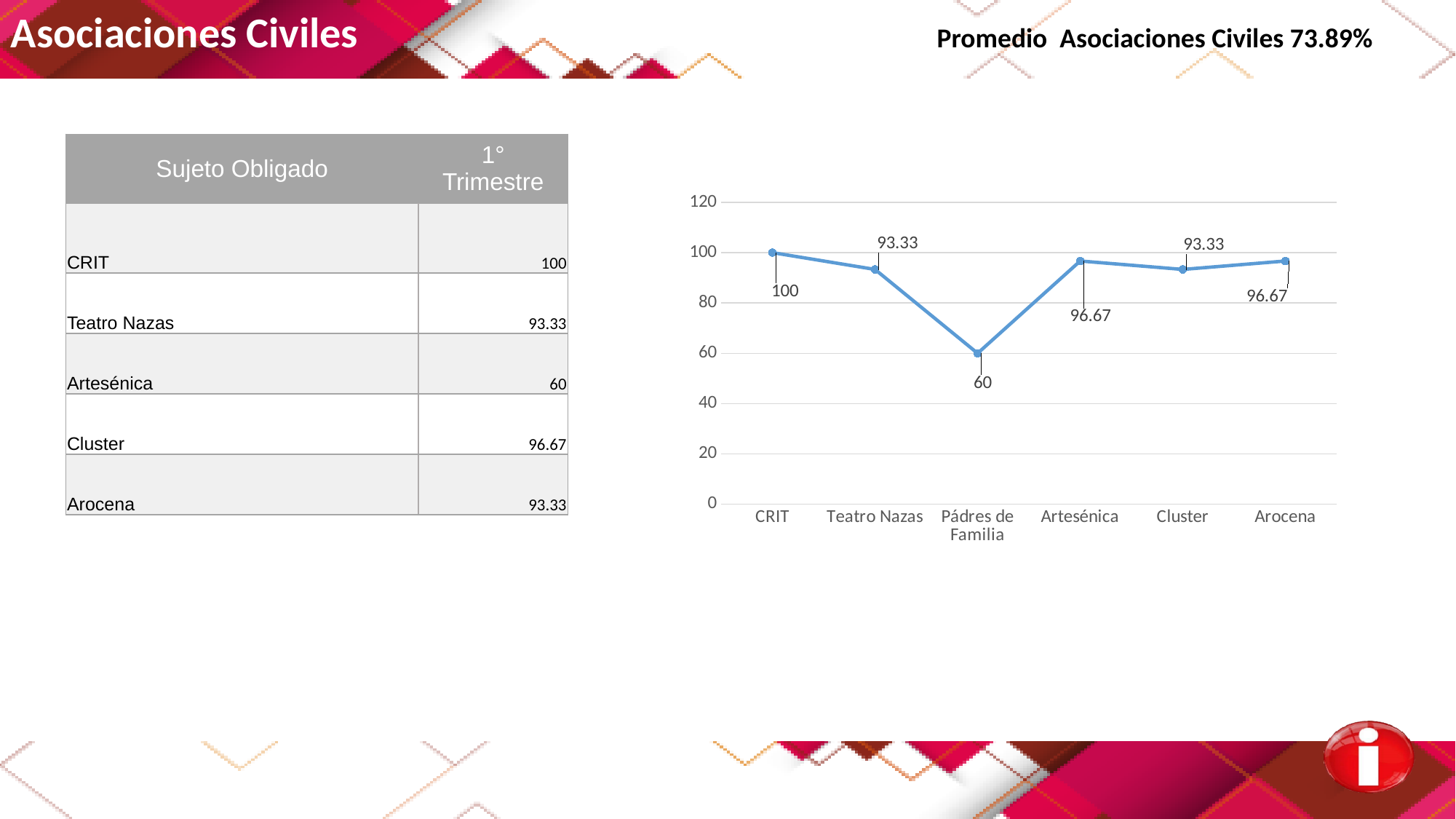
Which category has the lowest value in the chart? Pádres de Familia Which is larger in the chart, the value for Teatro Nazas or the value for Arocena? Arocena What is the value plotted for Cluster in the chart? 93.33 What kind of chart is shown on the slide? line chart How many categories are plotted along the x axis of the chart? 6 What is the difference between the values for CRIT and Pádres de Familia in the chart? 40 Which category has the highest value in the chart? CRIT What is the value plotted for CRIT in the chart? 100 Does the line rise or fall between Teatro Nazas and Pádres de Familia? fall What is the value plotted for Artesénica in the chart? 96.67 Is the value for Pádres de Familia in the chart greater or less than 80? less What is the value plotted for Pádres de Familia in the chart? 60